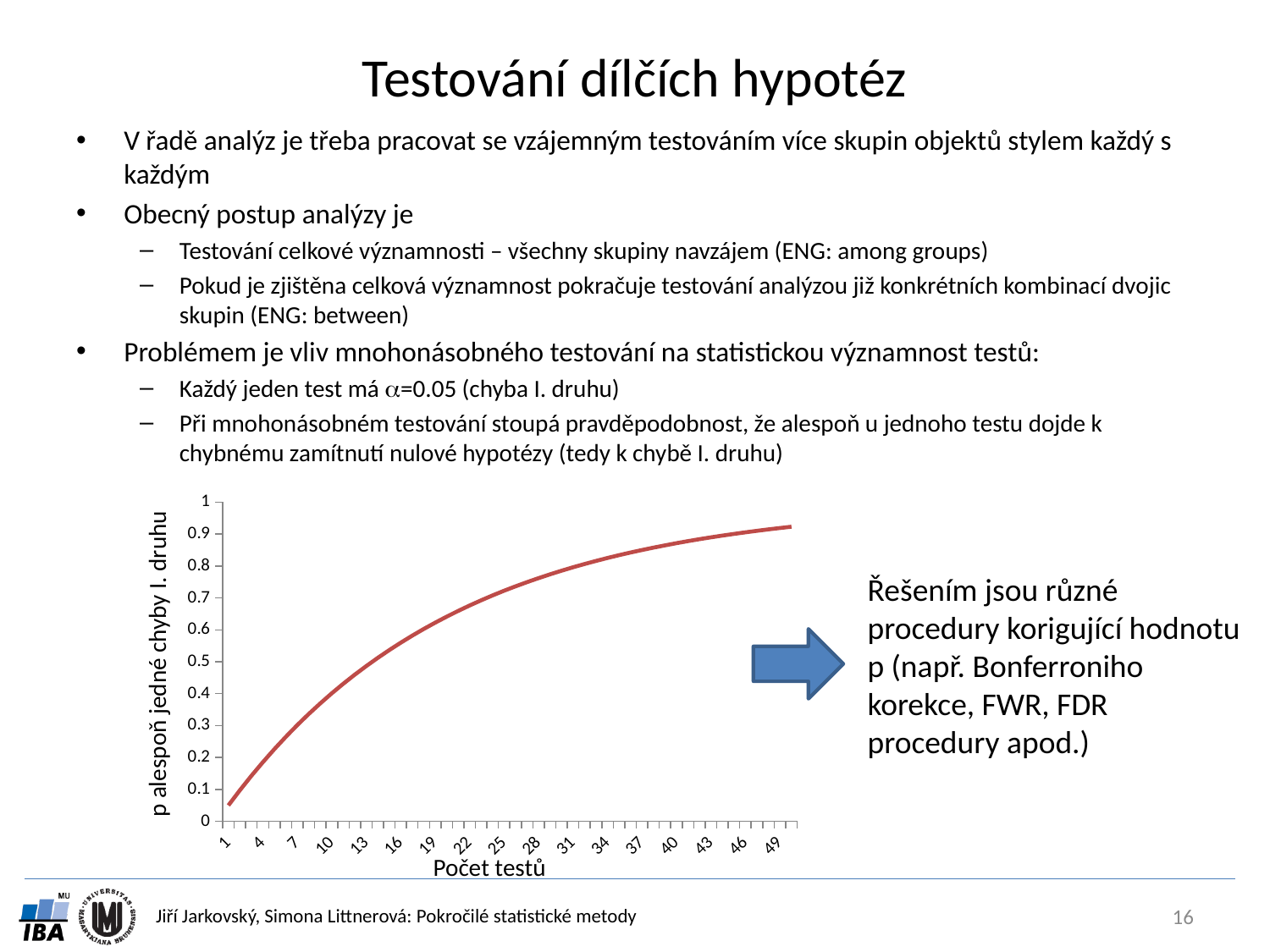
Is the value of the line at 22 tests greater or less than 0.6? greater Is the value of the line at 49 tests greater or less than 0.8? greater What is the label of the y axis of the chart? p alespoň jedné chyby I. druhu What is the highest value shown on the y axis of the chart? 1 What is the largest tick label shown on the x axis of the chart? 49 Is the value of the line at 1 test greater or less than 0.1? less What is the label of the x axis of the chart? Počet testů Does the plotted line rise or fall as the number of tests (Počet testů) increases? rises What kind of chart is shown on the slide? line chart How many lines are plotted on the chart? 1